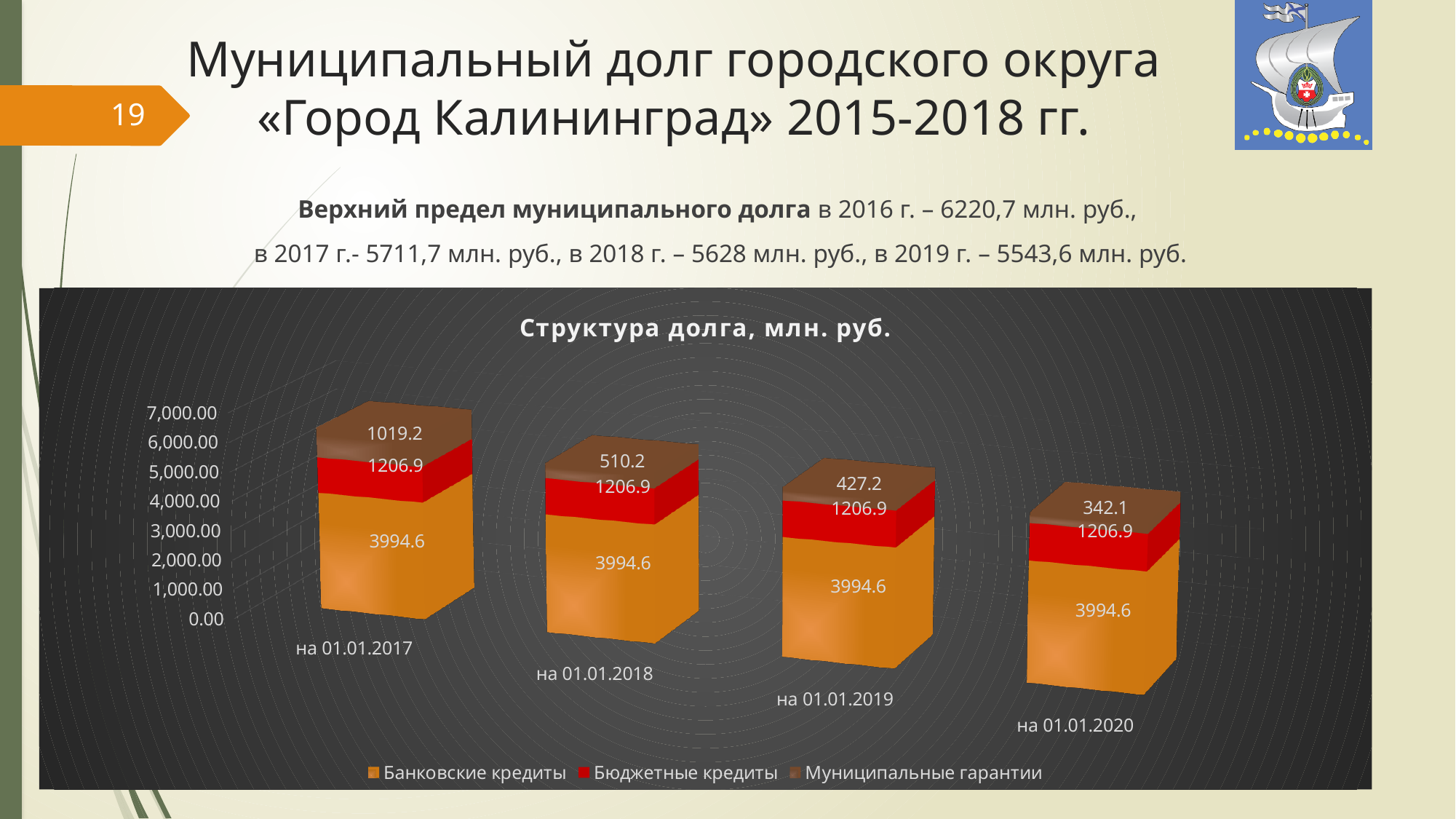
What is the value of Банковские кредиты for на 01.01.2019? 3994.6 What is the value of Муниципальные гарантии for на 01.01.2020? 342.1 For which category is the value of Муниципальные гарантии highest? на 01.01.2017 What is the difference between the Муниципальные гарантии values for на 01.01.2017 and на 01.01.2018? 509.0 What is the total of the stacked bar for на 01.01.2018? 5711.7 For which category is the value of Муниципальные гарантии lowest? на 01.01.2020 How many categories are shown on the x axis? 4 What is the value of Бюджетные кредиты for на 01.01.2018? 1206.9 What kind of chart is shown on the slide? Stacked bar chart How many series does the legend list? 3 What is the value of Муниципальные гарантии for на 01.01.2017? 1019.2 Which is larger: Муниципальные гарантии for на 01.01.2019 or for на 01.01.2020? на 01.01.2019